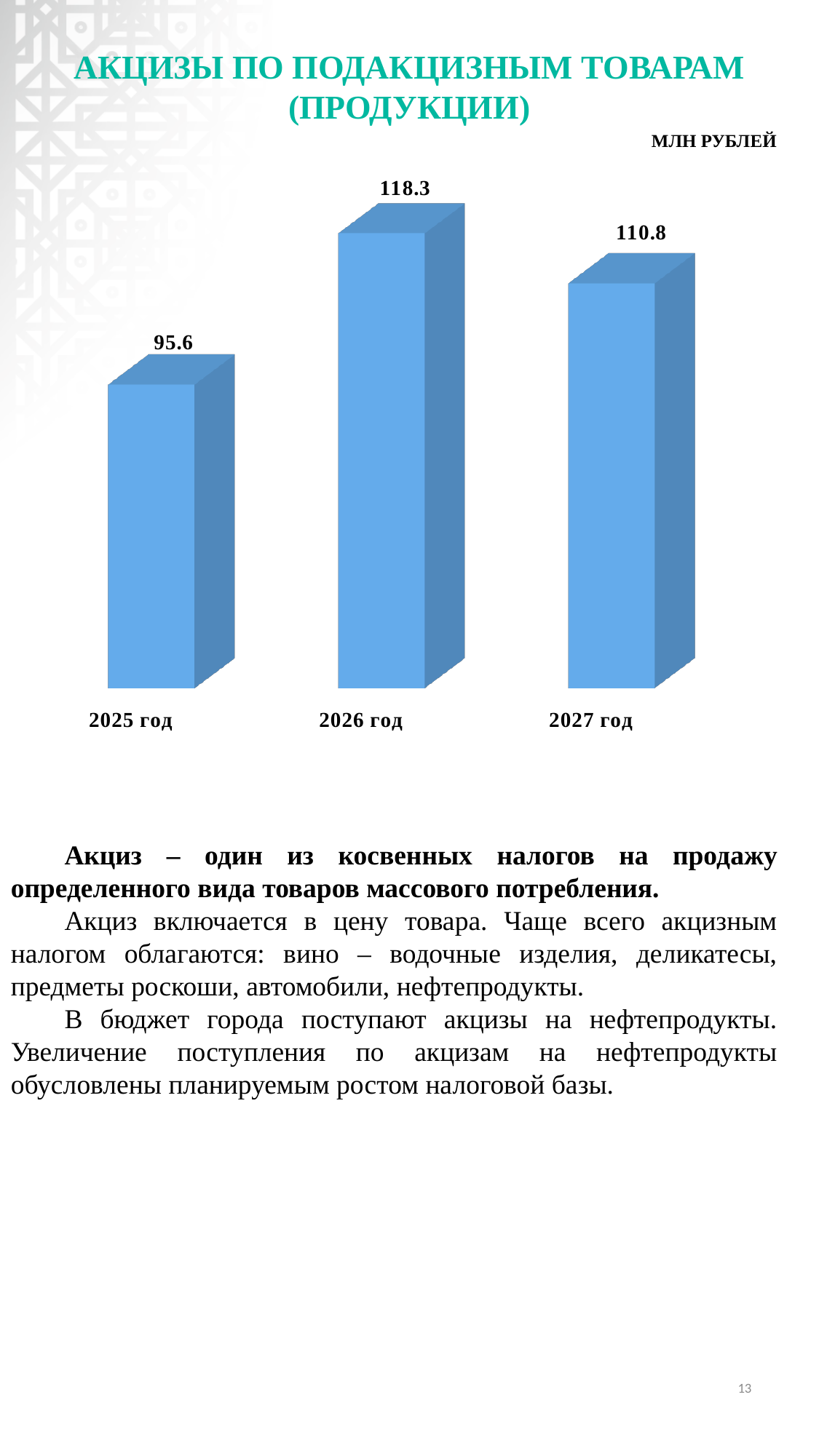
What is the difference between the values for 2026 год and 2025 год? 22.7 Does the value rise or fall from 2025 год to 2026 год? rise What is the value for 2025 год? 95.6 What kind of chart is shown on the slide? bar chart What is the value for 2027 год? 110.8 Which year has the highest value? 2026 год What is the difference between the values for 2026 год and 2027 год? 7.5 Which is larger, the value for 2027 год or the value for 2025 год? 2027 год Which year has the lowest value? 2025 год What is the value for 2026 год? 118.3 In what units are the chart values given? млн рублей How many years are shown in the chart? 3